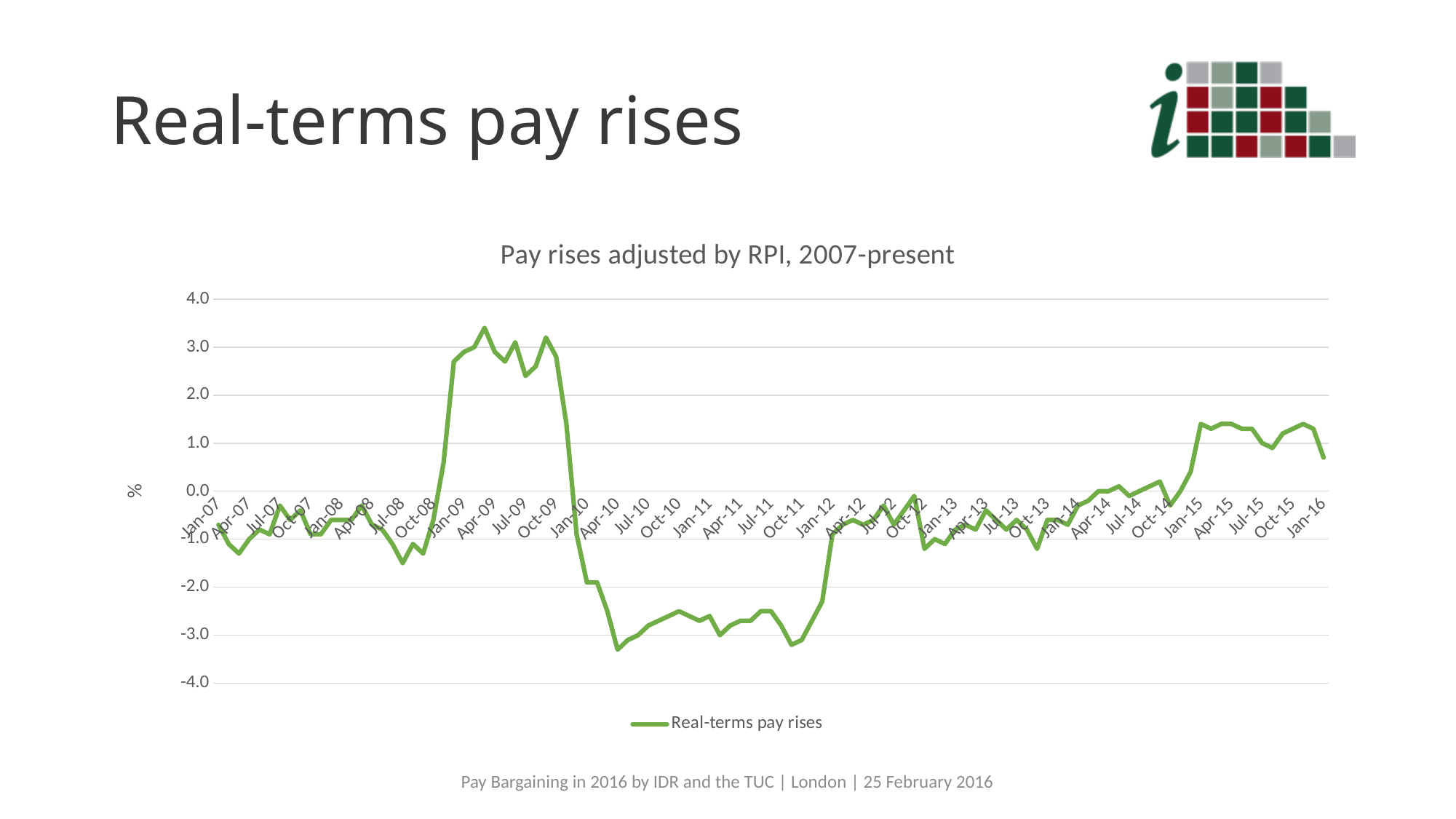
What is the title of the chart? Pay rises adjusted by RPI, 2007-present Is the value for Apr-15 greater or less than 1.0? greater Is the value for Apr-10 greater or less than -2.0? less Is the value for Jan-16 greater or less than 0.0? greater What is the name of the series shown in the legend? Real-terms pay rises Do the values rise or fall between Jan-10 and Apr-10? fall What kind of chart is shown on the slide? line chart Which is larger, the value for Apr-09 or the value for Apr-10? Apr-09 How many series does the legend list? 1